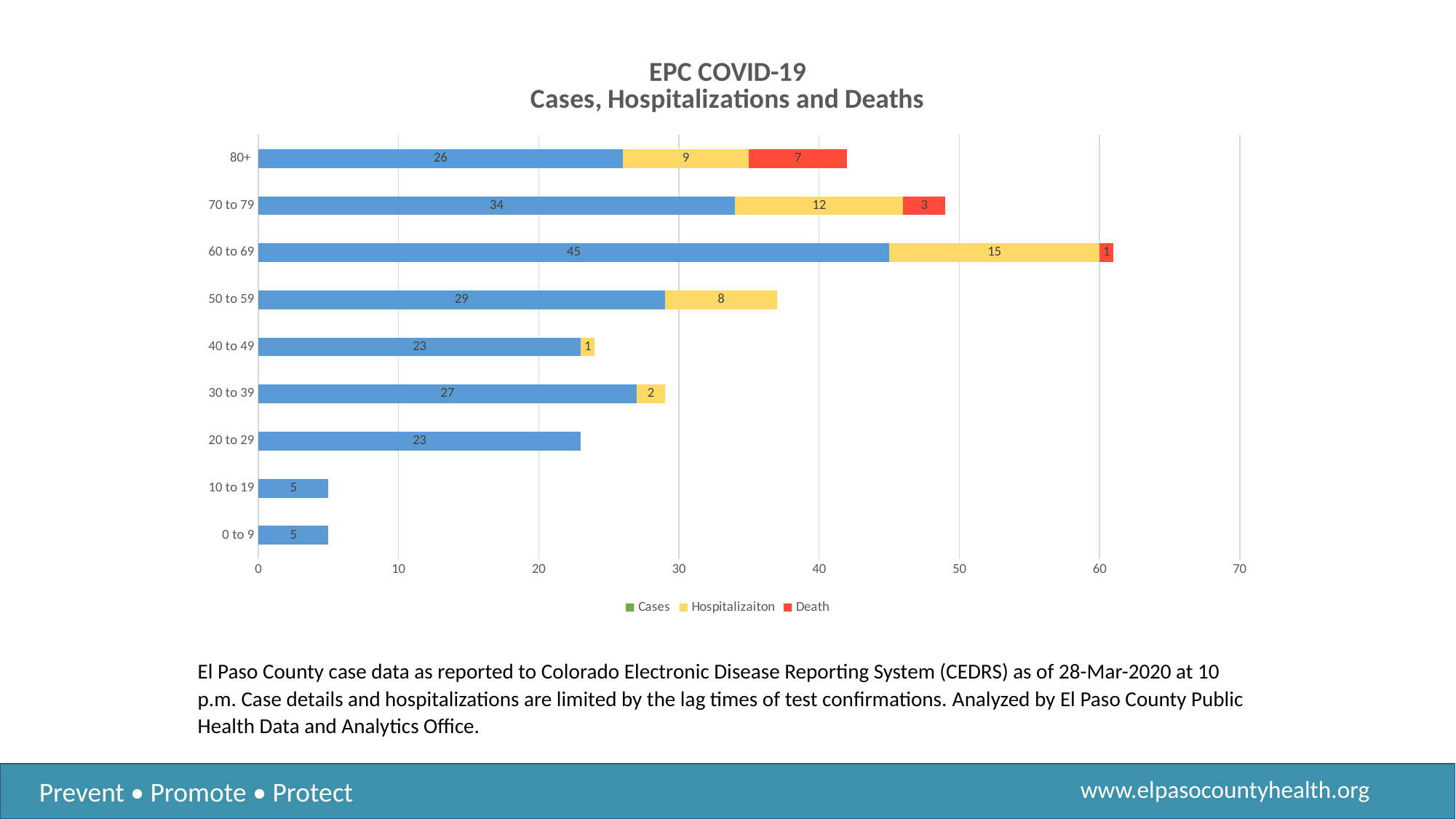
What is the number of deaths for the 80+ age group? 7 Which has more cases, the 50 to 59 age group or the 30 to 39 age group? 50 to 59 How many series does the legend list? 3 What is the difference in cases between the 60 to 69 and 70 to 79 age groups? 11 Which age group has the highest number of deaths? 80+ What is the number of cases for the 60 to 69 age group? 45 How many age groups are shown on the chart? 9 What kind of chart is shown on the slide? Stacked bar chart Which age group has the highest number of cases? 60 to 69 What is the total of the stacked bar for the 80+ age group? 42 What is the number of hospitalizations for the 70 to 79 age group? 12 What is the title of the chart? EPC COVID-19 Cases, Hospitalizations and Deaths